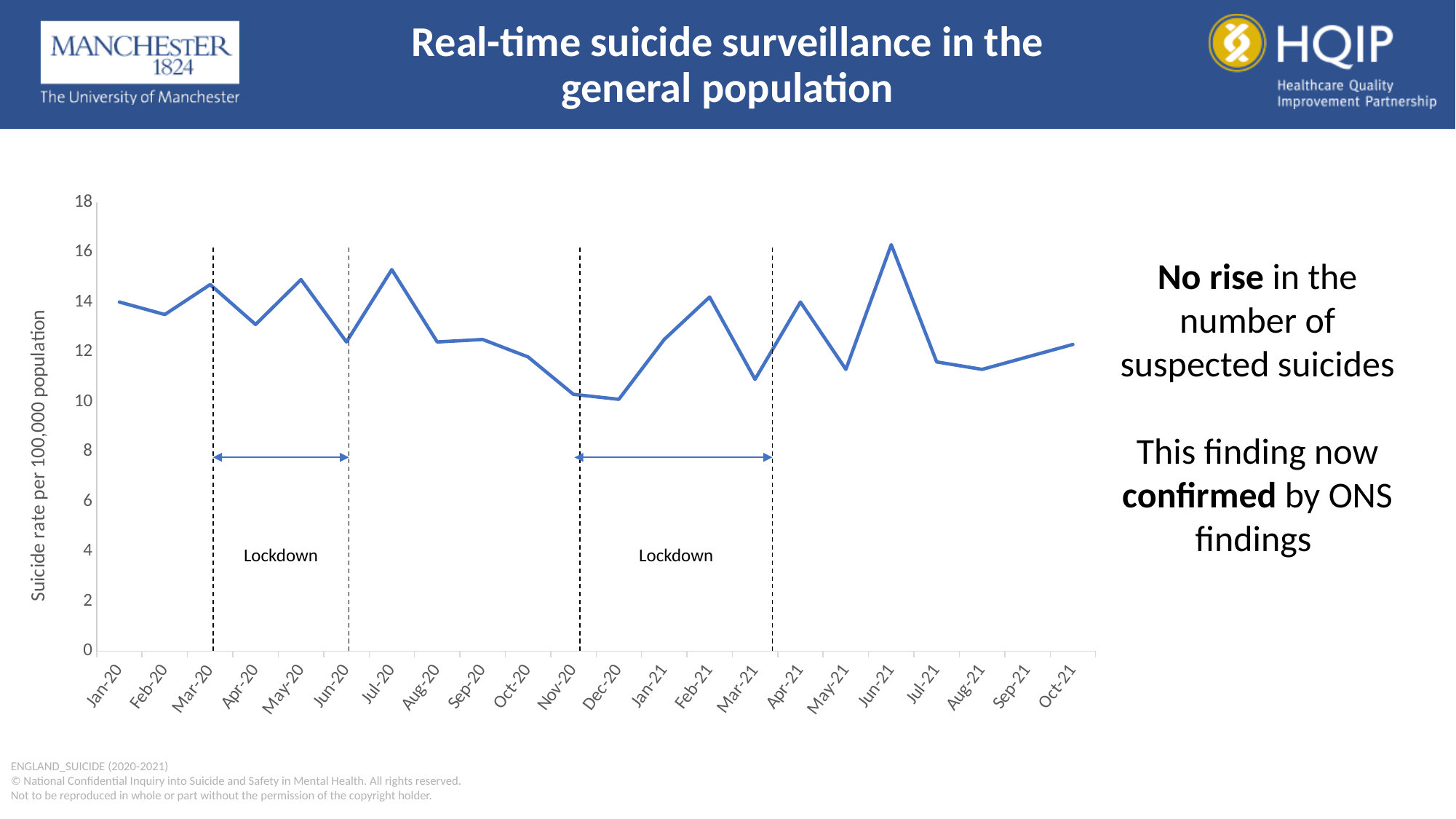
Is the value for Aug-21 greater or less than 12? less Does the suicide rate rise or fall from Jul-20 to Dec-20? fall Which month has the highest suicide rate on the chart? Jun-21 What kind of chart is shown on the slide? line chart Which is larger, the value for Jan-20 or the value for Dec-20? Jan-20 Is the value for Dec-20 greater or less than 12? less Is the value for Jun-21 greater or less than 14? greater How many monthly data points are plotted on the x axis? 22 How many lockdown periods are marked on the chart? 2 What is the label on the y axis of the chart? Suicide rate per 100,000 population Which is larger, the value for Jun-21 or the value for Jul-20? Jun-21